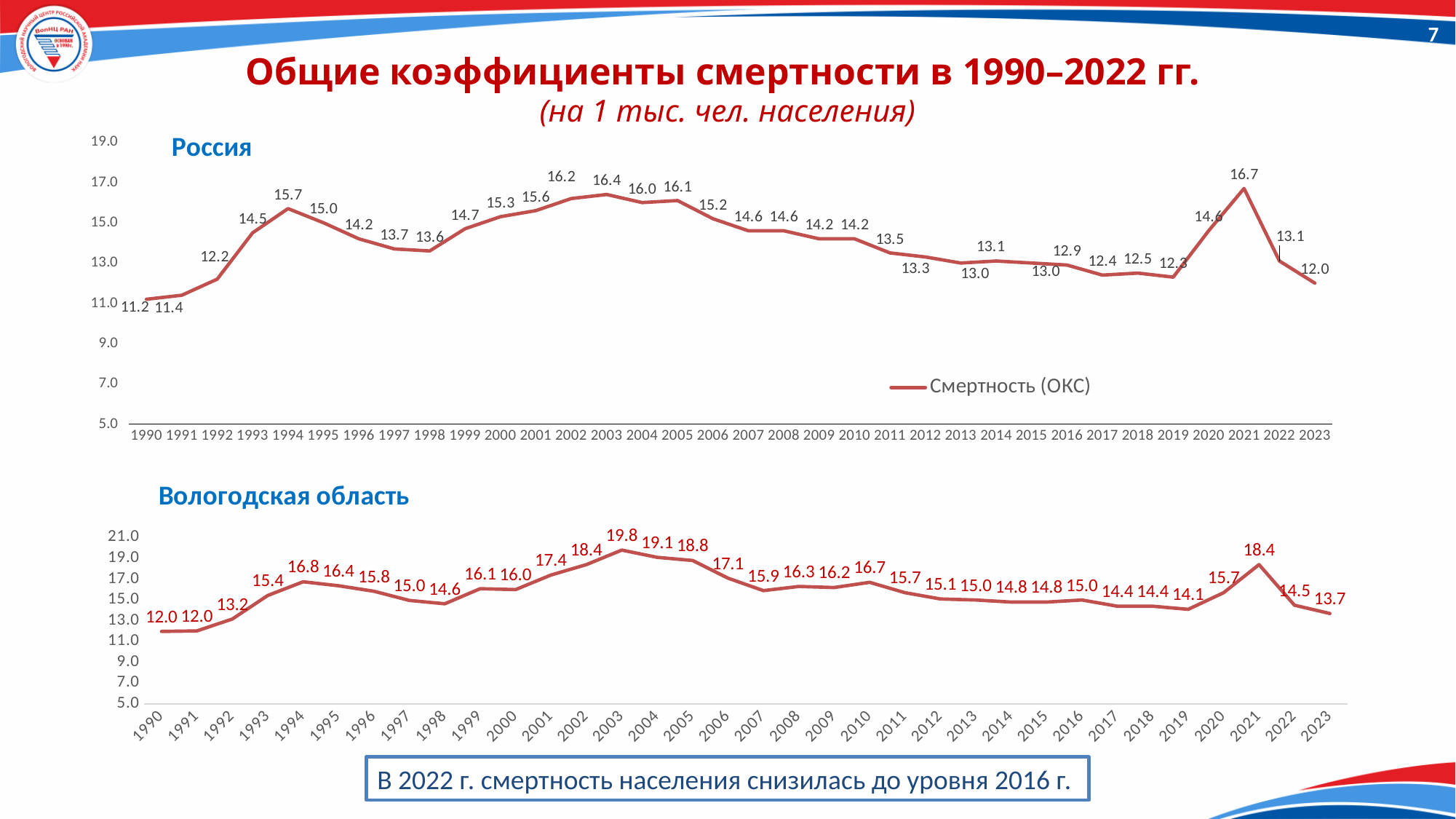
In the "Вологодская область" chart, which is larger, the value for 2021 or the value for 2020? 2021 In the "Россия" chart, what is the value for 1990? 11.2 In the "Вологодская область" chart, what is the value for 2003? 19.8 In the "Вологодская область" chart, which year has the highest value? 2003 In the "Россия" chart, which year has the lowest value? 1990 What is the legend entry shown in the "Россия" chart? Смертность (ОКС) In the "Вологодская область" chart, what is the value for 2023? 13.7 What type of chart is the "Россия" chart? line chart In the "Россия" chart, what is the difference between the values for 2021 and 2022? 3.6 How many years are plotted on the x axis of the "Россия" chart? 34 In the "Россия" chart, what is the value for 2021? 16.7 In the "Россия" chart, which year has the highest value? 2021